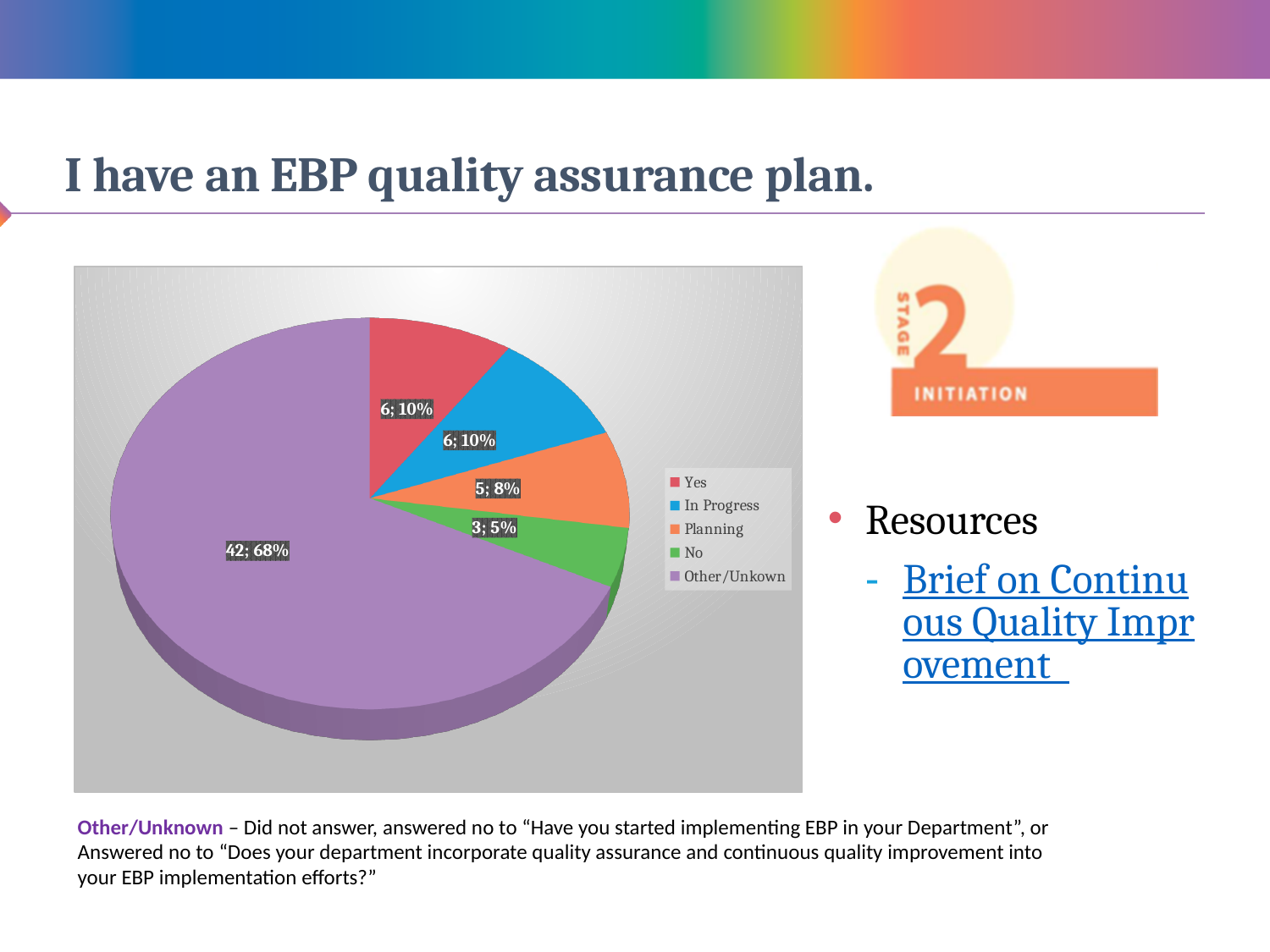
What is the count for the No slice? 3 Which is larger, the Planning slice or the No slice? Planning What is the difference in count between the Other/Unkown slice and the Yes slice? 36 What is the count for the Yes slice? 6 Which category has the smallest slice? No Which category has the largest slice? Other/Unkown What percentage of the pie is the In Progress slice? 10% What is the title of the slide containing the pie chart? I have an EBP quality assurance plan. What kind of chart is shown on the slide? pie chart What percentage of the pie is the Other/Unkown slice? 68% What percentage of the pie is the Planning slice? 8% How many slices does the pie chart have? 5